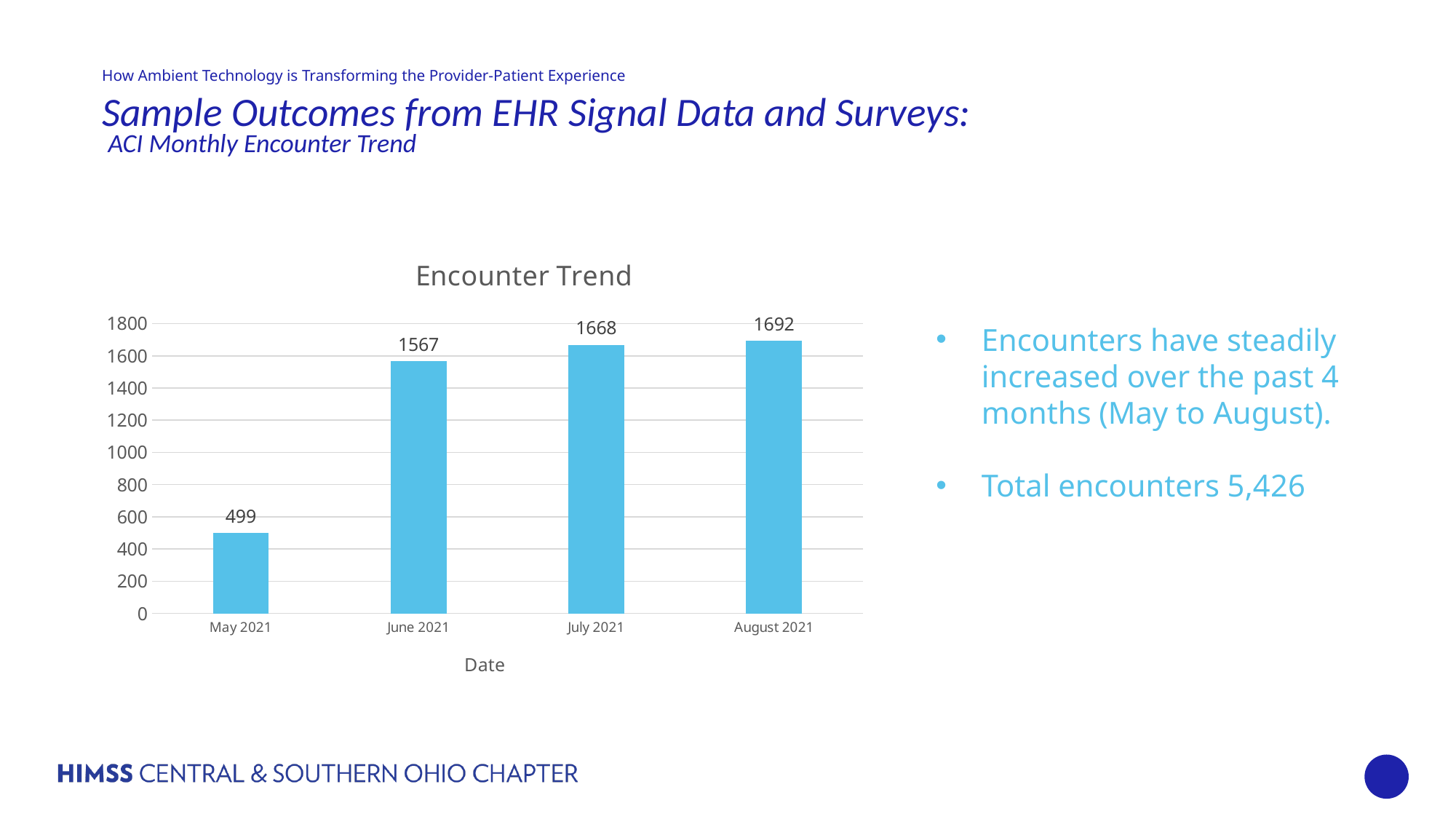
How many months are shown on the x axis of the Encounter Trend chart? 4 What kind of chart is the Encounter Trend chart? Bar chart What is the value for June 2021 in the Encounter Trend chart? 1567 What is the value for May 2021 in the Encounter Trend chart? 499 What is the value for August 2021 in the Encounter Trend chart? 1692 What is the value for July 2021 in the Encounter Trend chart? 1668 Which is larger in the Encounter Trend chart, the value for June 2021 or the value for July 2021? July 2021 Which month has the highest value in the Encounter Trend chart? August 2021 What is the difference between the values for August 2021 and July 2021 in the Encounter Trend chart? 24 Which month has the lowest value in the Encounter Trend chart? May 2021 What is the difference between the values for June 2021 and May 2021 in the Encounter Trend chart? 1068 Do the values in the Encounter Trend chart rise or fall from May 2021 to August 2021? Rise